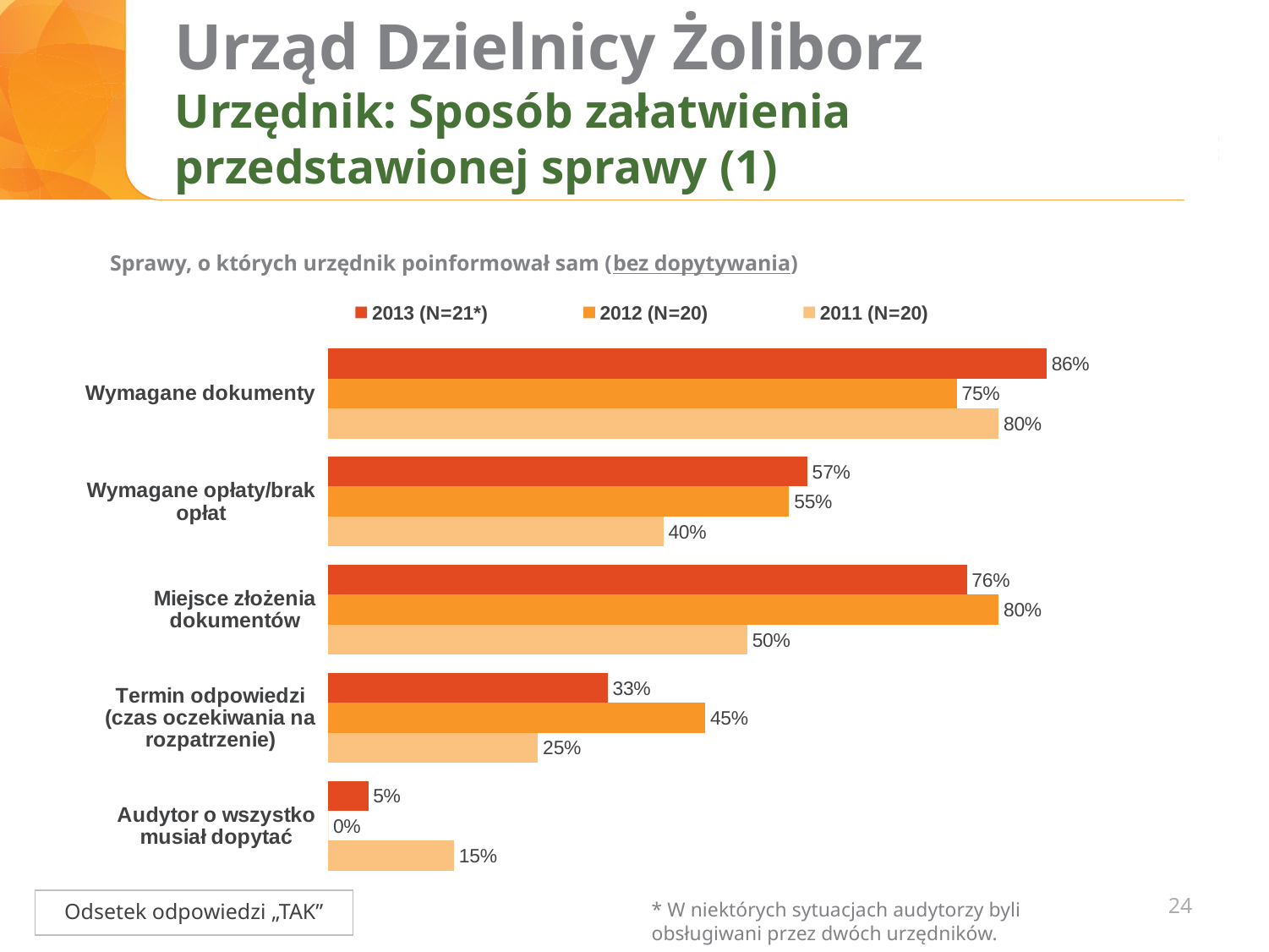
What is the subtitle printed above the chart legend? Sprawy, o których urzędnik poinformował sam (bez dopytywania) How many categories are shown on the chart? 5 What kind of chart is shown on the slide? bar chart What is the difference between the 2013 (N=21*) and 2011 (N=20) values for Miejsce złożenia dokumentów? 26% Which is larger for Wymagane opłaty/brak opłat: the 2013 (N=21*) value or the 2011 (N=20) value? 2013 (N=21*) What is the value for Wymagane dokumenty in the 2013 (N=21*) series? 86% What is the value for Termin odpowiedzi (czas oczekiwania na rozpatrzenie) in the 2012 (N=20) series? 45% What is the difference between the 2012 (N=20) and 2013 (N=21*) values for Termin odpowiedzi (czas oczekiwania na rozpatrzenie)? 12% What is the value for Audytor o wszystko musiał dopytać in the 2011 (N=20) series? 15% How many series does the legend list? 3 Which category has the lowest value in the 2012 (N=20) series? Audytor o wszystko musiał dopytać Which category has the highest value in the 2013 (N=21*) series? Wymagane dokumenty